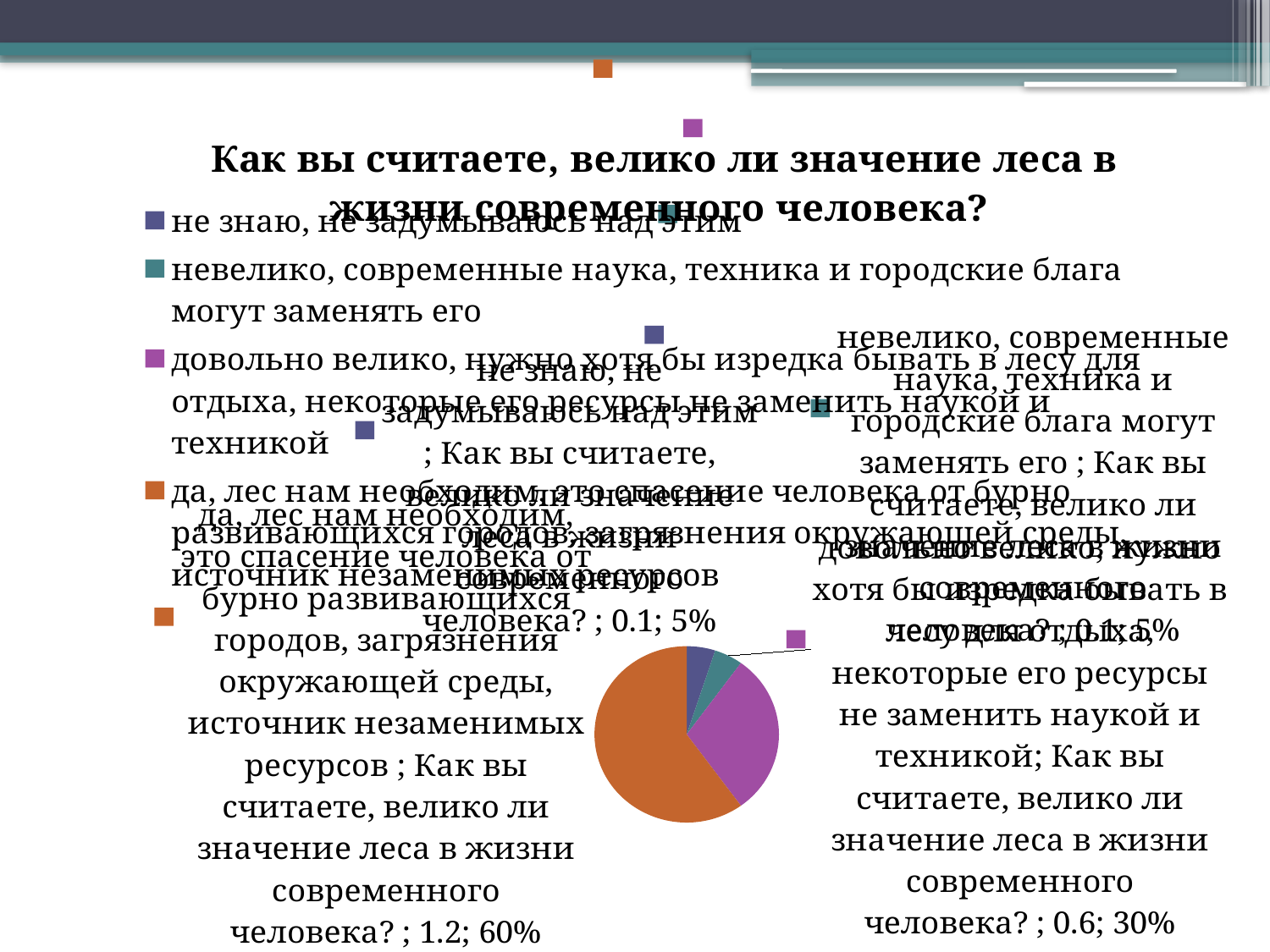
What percentage share does the slice "не знаю, не задумываюсь над этим" have? 5% How many slices does the pie chart have? 4 Which answer option has the largest slice of the pie? да, лес нам необходим, это спасение человека от бурно развивающихся городов, загрязнения окружающей среды, источник незаменимых ресурсов What kind of chart is shown on the slide? pie chart What value is printed in the data label for "да, лес нам необходим..." before the percentage? 1.2 Which slice is larger: "довольно велико..." or "невелико..."? довольно велико... What is the difference in percentage points between the "да, лес нам необходим..." slice and the "довольно велико..." slice? 30 What percentage share does the slice "невелико, современные наука, техника и городские блага могут заменять его" have? 5% What is the title of the chart? Как вы считаете, велико ли значение леса в жизни современного человека? What percentage share does the slice "довольно велико, нужно хотя бы изредка бывать в лесу..." have? 30% How many entries does the legend list? 4